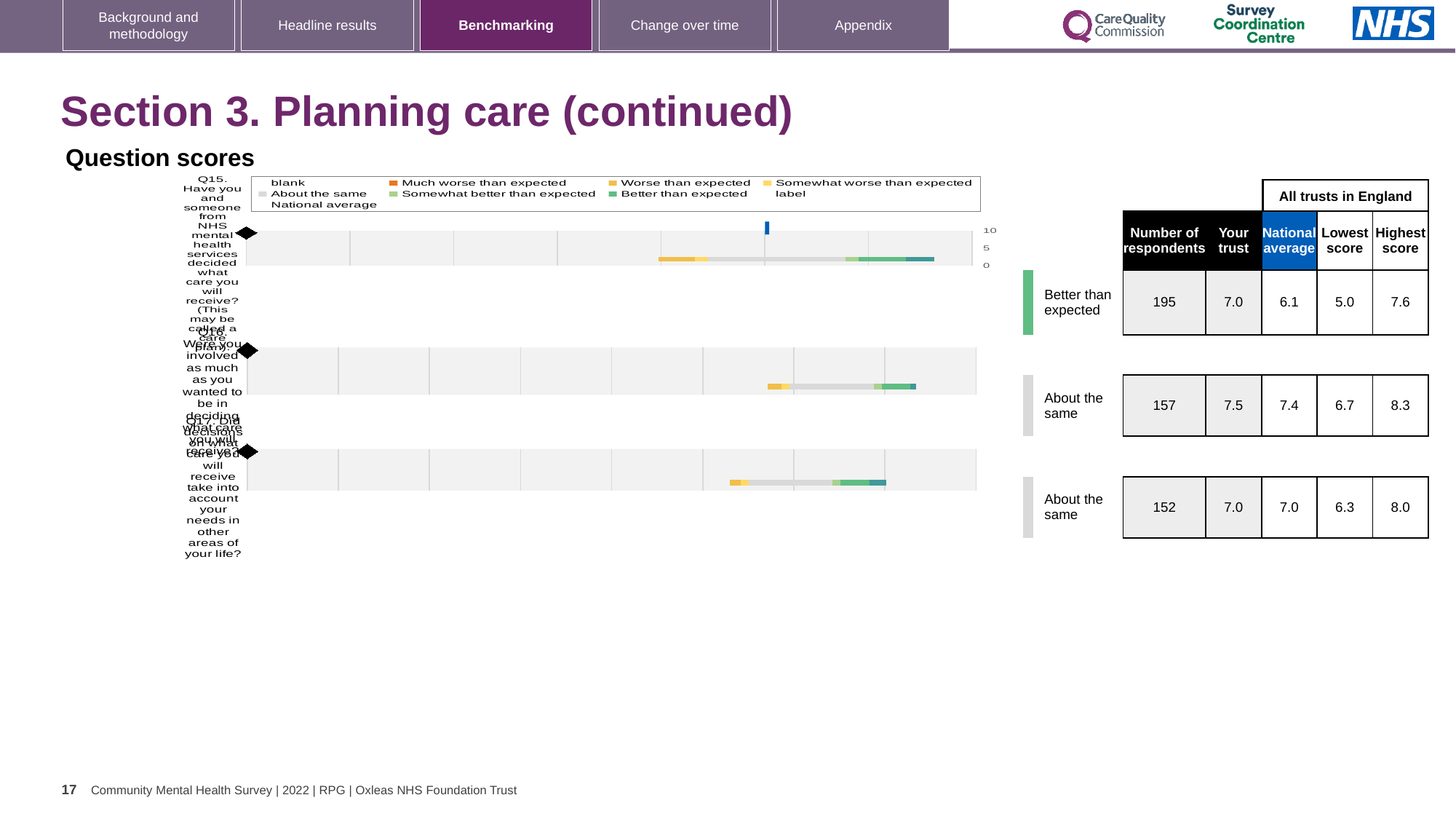
How many respondents answered Q16 (Were you involved as much as you wanted to be in deciding what care you will receive?)? 157 What is the lowest score among all trusts in England for Q16? 6.7 For Q16, which is larger: the 'Your trust' score or the national average? Your trust What is the national average score for Q15? 6.1 What is the 'Your trust' score for Q15 (Have you and someone from NHS mental health services decided what care you will receive?)? 7.0 Which question has the highest 'Your trust' score? Q16 How many questions are plotted in the Question scores chart? 3 What kind of chart is shown under 'Question scores'? bar chart Which benchmark category is Q17 rated as? About the same Which benchmark category is Q15 rated as? Better than expected What is the difference between the 'Your trust' score and the national average for Q15? 0.9 What is the highest score among all trusts in England for Q17? 8.0